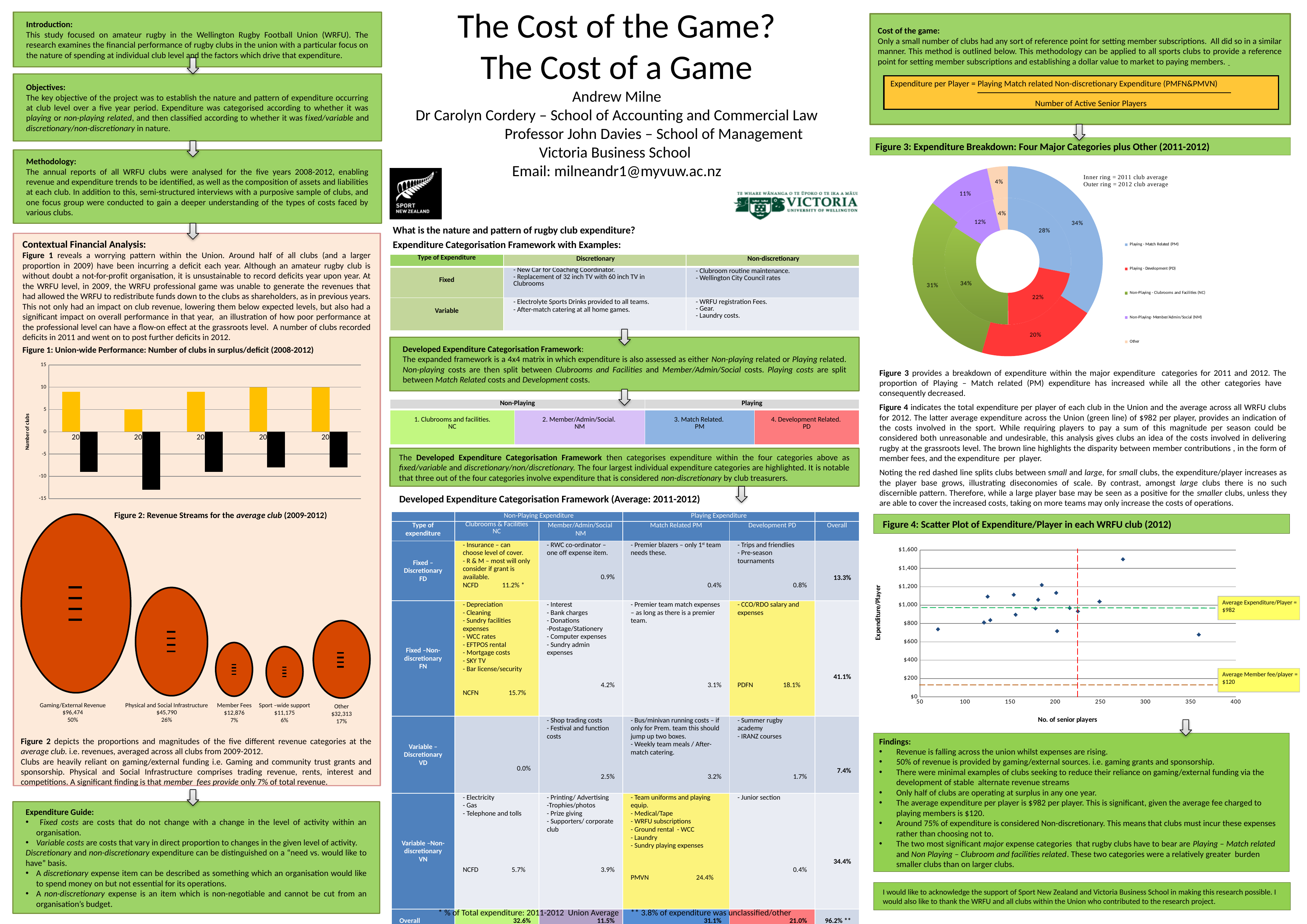
What kind of chart is Figure 1: Union-wide Performance: Number of clubs in surplus/deficit (2008-2012)? bar chart In Figure 3: Expenditure Breakdown, what share of 2011 expenditure (inner ring) is Non-Playing - Clubrooms and Facilities (NC)? 34% In Figure 2: Revenue Streams for the average club (2009-2012), what is the difference between Physical and Social Infrastructure and Other? $13,477 In Figure 3: Expenditure Breakdown, how many categories does the legend list? 5 In Figure 2: Revenue Streams for the average club (2009-2012), how many revenue categories are shown? 5 In Figure 3: Expenditure Breakdown, which category has the smallest share in the 2012 outer ring? Other In Figure 3: Expenditure Breakdown, is the 2012 share for Playing - Development (PD) larger or smaller than the 2011 share? smaller In Figure 2: Revenue Streams for the average club (2009-2012), what percentage of revenue comes from Member Fees? 7% In Figure 4: Scatter Plot of Expenditure/Player in each WRFU club (2012), what is the Average Expenditure/Player shown by the green line? $982 In Figure 3: Expenditure Breakdown, what share of 2012 expenditure (outer ring) is Playing - Match Related (PM)? 34% In Figure 2: Revenue Streams for the average club (2009-2012), what is the value for Gaming/External Revenue? $96,474 In Figure 2: Revenue Streams for the average club (2009-2012), which revenue category is the smallest? Sport-wide support